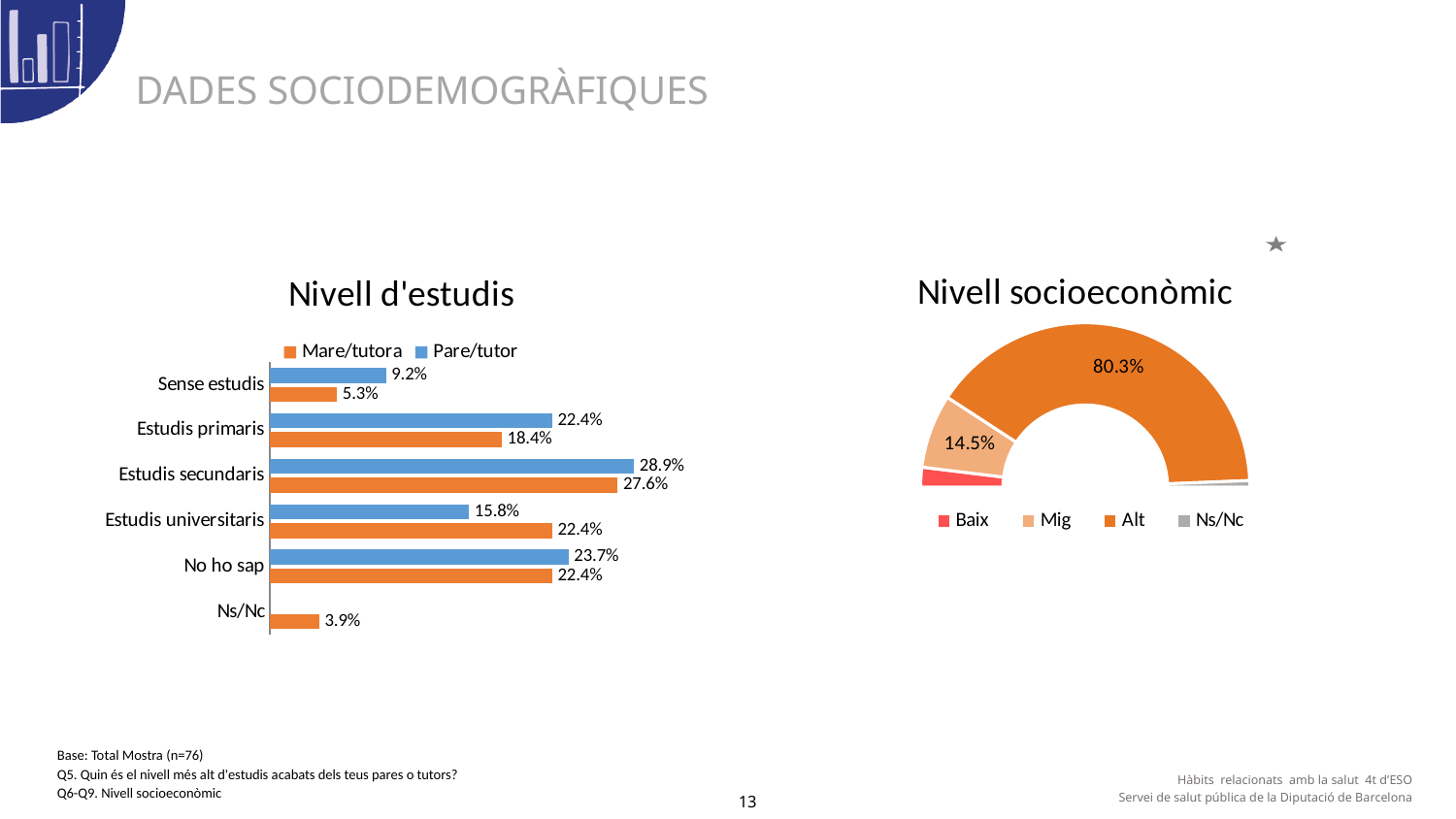
In the 'Nivell d'estudis' chart, for Estudis universitaris, which series has the larger value, Mare/tutora or Pare/tutor? Mare/tutora In the 'Nivell socioeconòmic' chart, what share does the Alt segment represent? 80.3% In the 'Nivell d'estudis' chart, what is the Pare/tutor value for Estudis secundaris? 28.9% In the 'Nivell d'estudis' chart, what is the Mare/tutora value for Estudis universitaris? 22.4% How many entries does the legend of the 'Nivell socioeconòmic' chart list? 4 In the 'Nivell d'estudis' chart, which category has the lowest Mare/tutora value? Ns/Nc In the 'Nivell d'estudis' chart, what is the Mare/tutora value for Sense estudis? 5.3% How many categories are shown on the 'Nivell d'estudis' chart? 6 How many series does the legend of the 'Nivell d'estudis' chart list? 2 What kind of chart is the 'Nivell d'estudis' chart? Bar chart In the 'Nivell d'estudis' chart, what is the difference between the Pare/tutor and Mare/tutora values for Estudis primaris? 4.0 percentage points In the 'Nivell d'estudis' chart, which category has the highest Pare/tutor value? Estudis secundaris